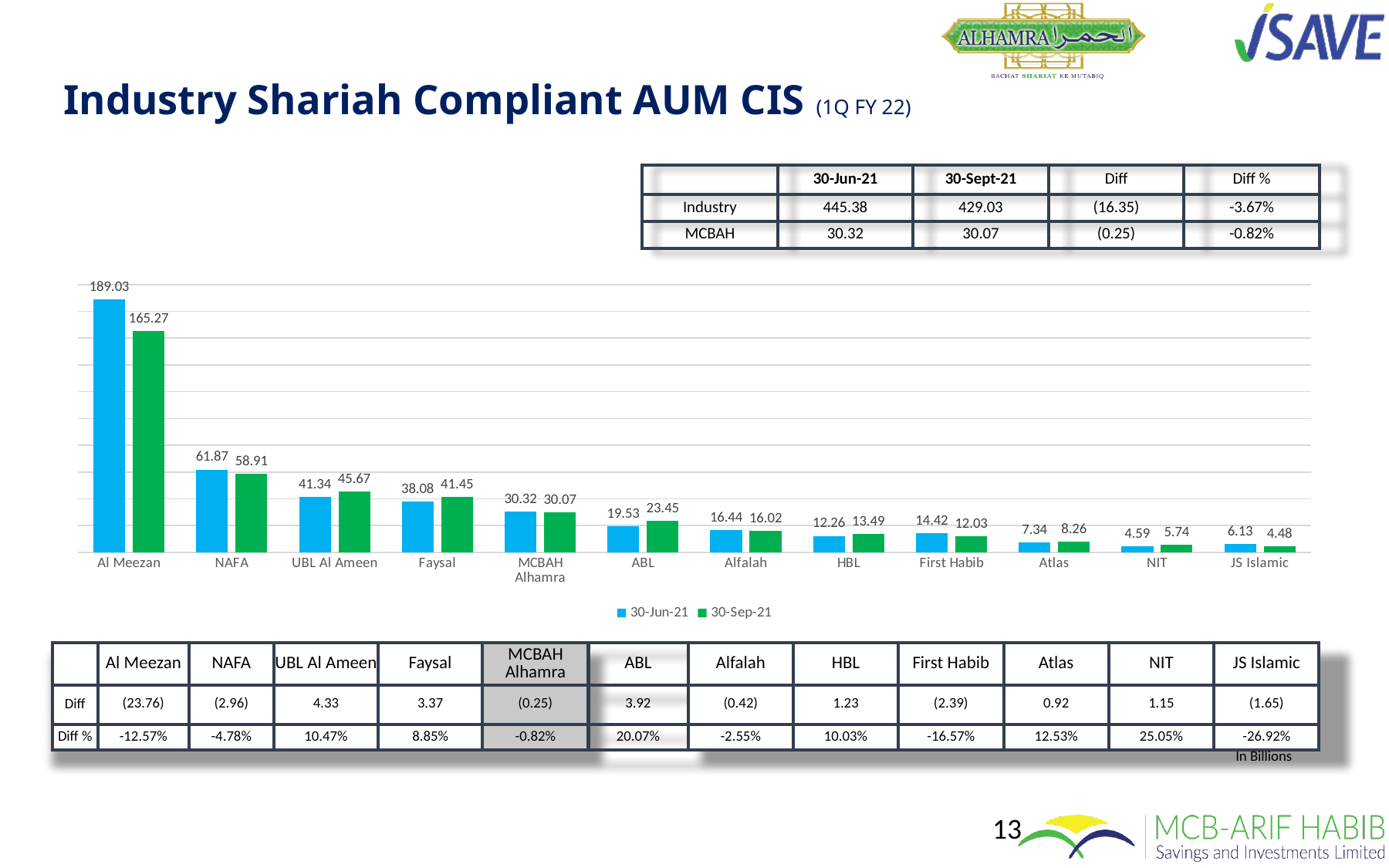
How many categories are shown on the x axis of the chart? 12 What is the difference between the 30-Jun-21 and 30-Sep-21 values for Al Meezan? 23.76 Which is larger for First Habib, the 30-Jun-21 value or the 30-Sep-21 value? 30-Jun-21 Which category has the highest 30-Jun-21 value? Al Meezan What is the difference between the 30-Sep-21 and 30-Jun-21 values for ABL? 3.92 Which is larger for Faysal, the 30-Jun-21 value or the 30-Sep-21 value? 30-Sep-21 Which category has the lowest 30-Sep-21 value? JS Islamic What kind of chart is shown on the slide? Bar chart What is the 30-Sep-21 value for MCBAH Alhamra? 30.07 What is the 30-Sep-21 value for UBL Al Ameen? 45.67 What is the 30-Jun-21 value for Al Meezan? 189.03 How many series does the chart legend list? 2